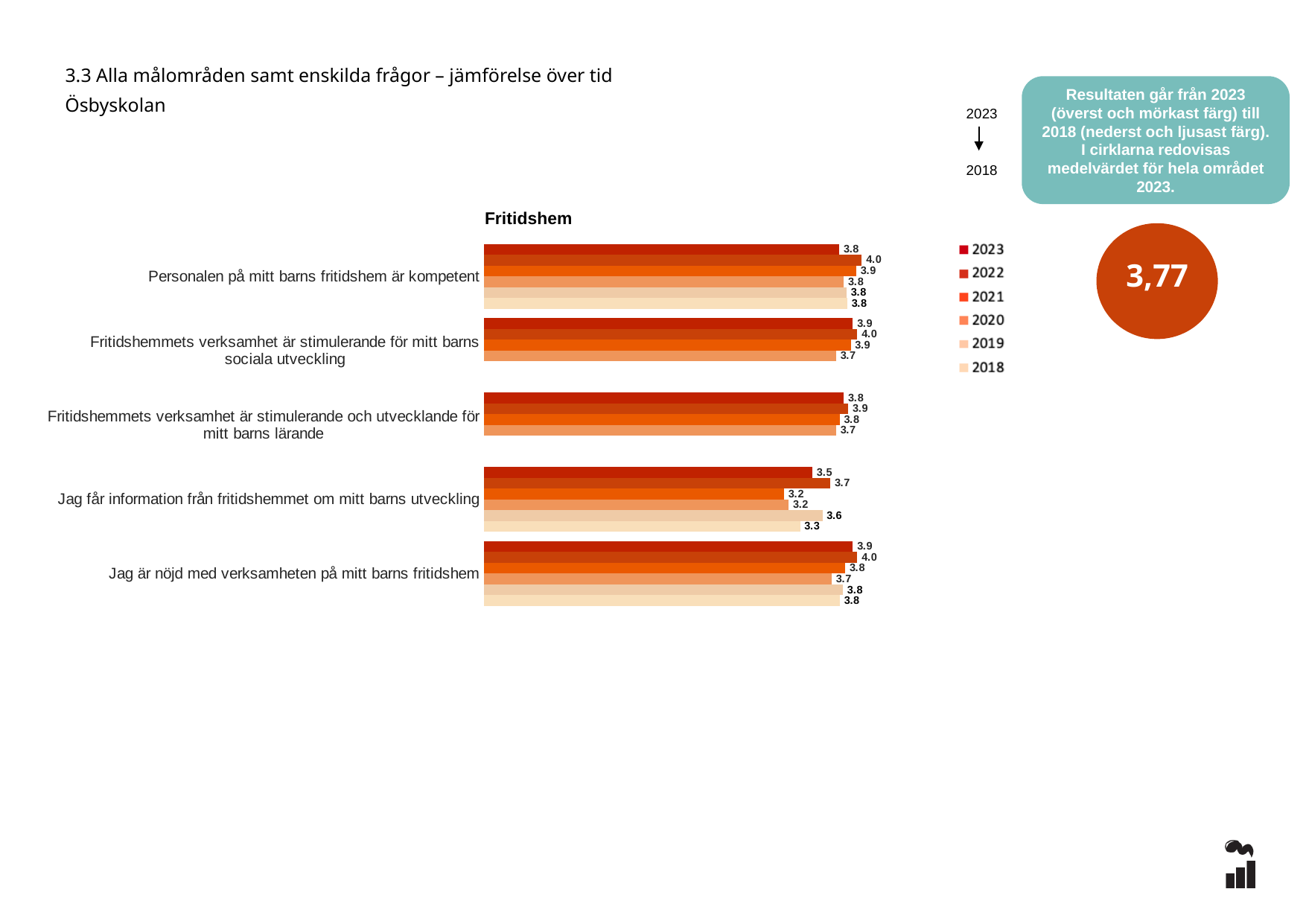
Which year is shown with the darkest colour in the "Fritidshem" chart legend? 2023 What is the 2020 value for "Fritidshemmets verksamhet är stimulerande och utvecklande för mitt barns lärande"? 3.7 What is the 2023 value for "Jag får information från fritidshemmet om mitt barns utveckling"? 3.5 What type of chart is shown under the title "Fritidshem"? bar chart What is the 2023 value for "Personalen på mitt barns fritidshem är kompetent"? 3.8 How many categories (statements) are shown in the "Fritidshem" chart? 5 What mean value for the whole area in 2023 is shown in the circle on the slide? 3,77 How many series does the legend of the "Fritidshem" chart list? 6 Which statement has the lowest 2023 value in the "Fritidshem" chart? Jag får information från fritidshemmet om mitt barns utveckling What is the 2022 value for "Jag är nöjd med verksamheten på mitt barns fritidshem"? 4.0 What is the difference between the 2022 and 2021 values for "Jag får information från fritidshemmet om mitt barns utveckling"? 0.5 For "Jag får information från fritidshemmet om mitt barns utveckling", which is larger: the 2019 value or the 2018 value? 2019